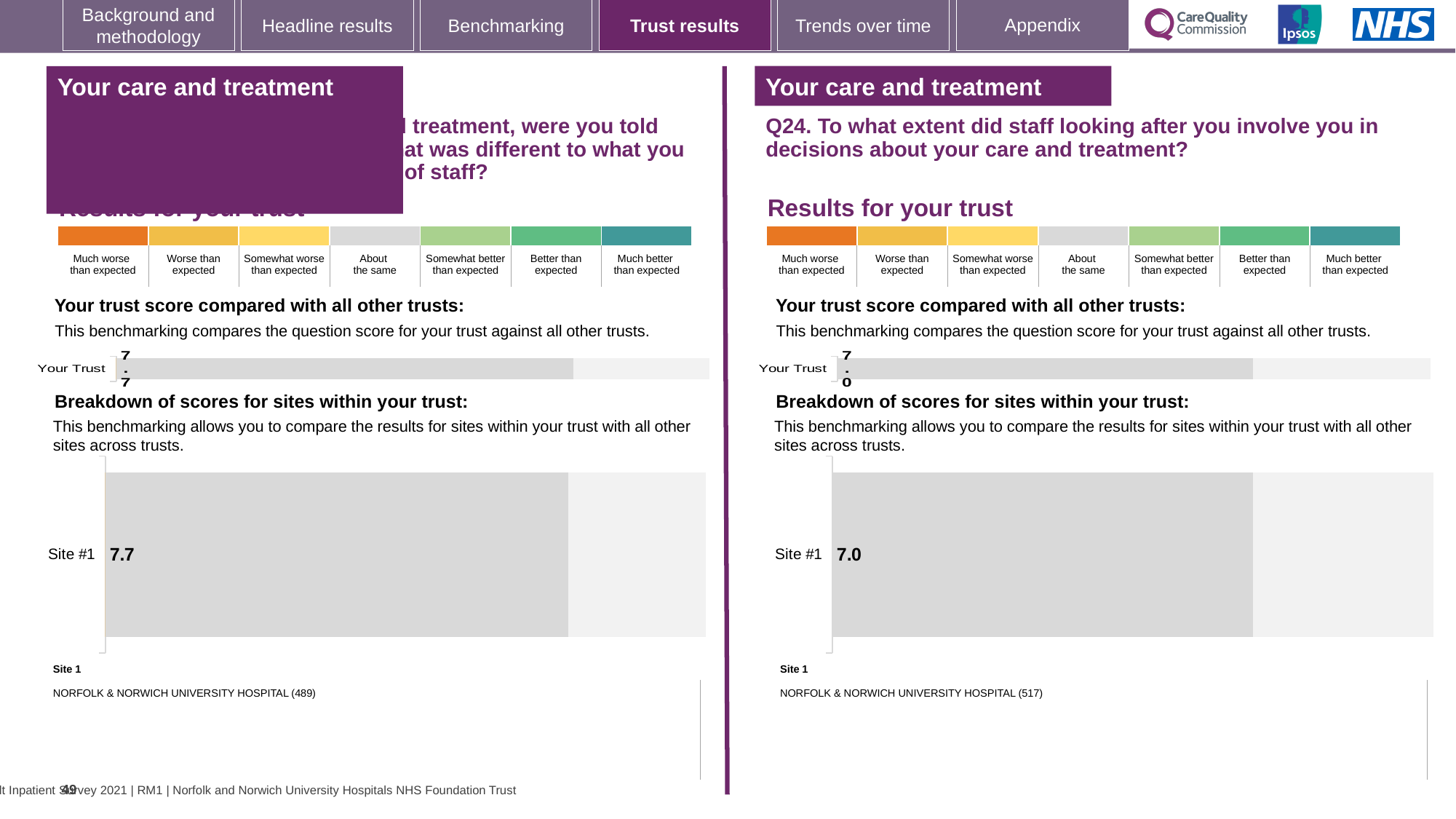
What is the difference between the Site #1 score on the left panel and the Site #1 score on the right panel (Q24)? 0.7 What type of chart is used for the 'Your Trust' score on the right panel (Q24)? Bar chart How many sites are shown in the right panel (Q24) 'Breakdown of scores for sites within your trust' chart? 1 How many categories are shown in the colour scale legend above 'Your trust score compared with all other trusts' on the right panel (Q24)? 7 On the left panel's 'Your trust score compared with all other trusts' chart, what is the score for Your Trust? 7.7 On the left panel's 'Breakdown of scores for sites within your trust' chart, what is the score for Site #1? 7.7 Which site name is listed as Site 1 below the right panel (Q24) site breakdown chart? NORFOLK & NORWICH UNIVERSITY HOSPITAL (517) How many sites are shown in the left panel's 'Breakdown of scores for sites within your trust' chart? 1 Which is larger: the Your Trust score on the left panel or the Your Trust score on the right panel (Q24)? Left panel On the right panel (Q24) 'Breakdown of scores for sites within your trust' chart, what is the score for Site #1? 7.0 What type of chart is used for the 'Breakdown of scores for sites within your trust' on the left panel? Bar chart On the right panel (Q24) 'Your trust score compared with all other trusts' chart, what is the score for Your Trust? 7.0